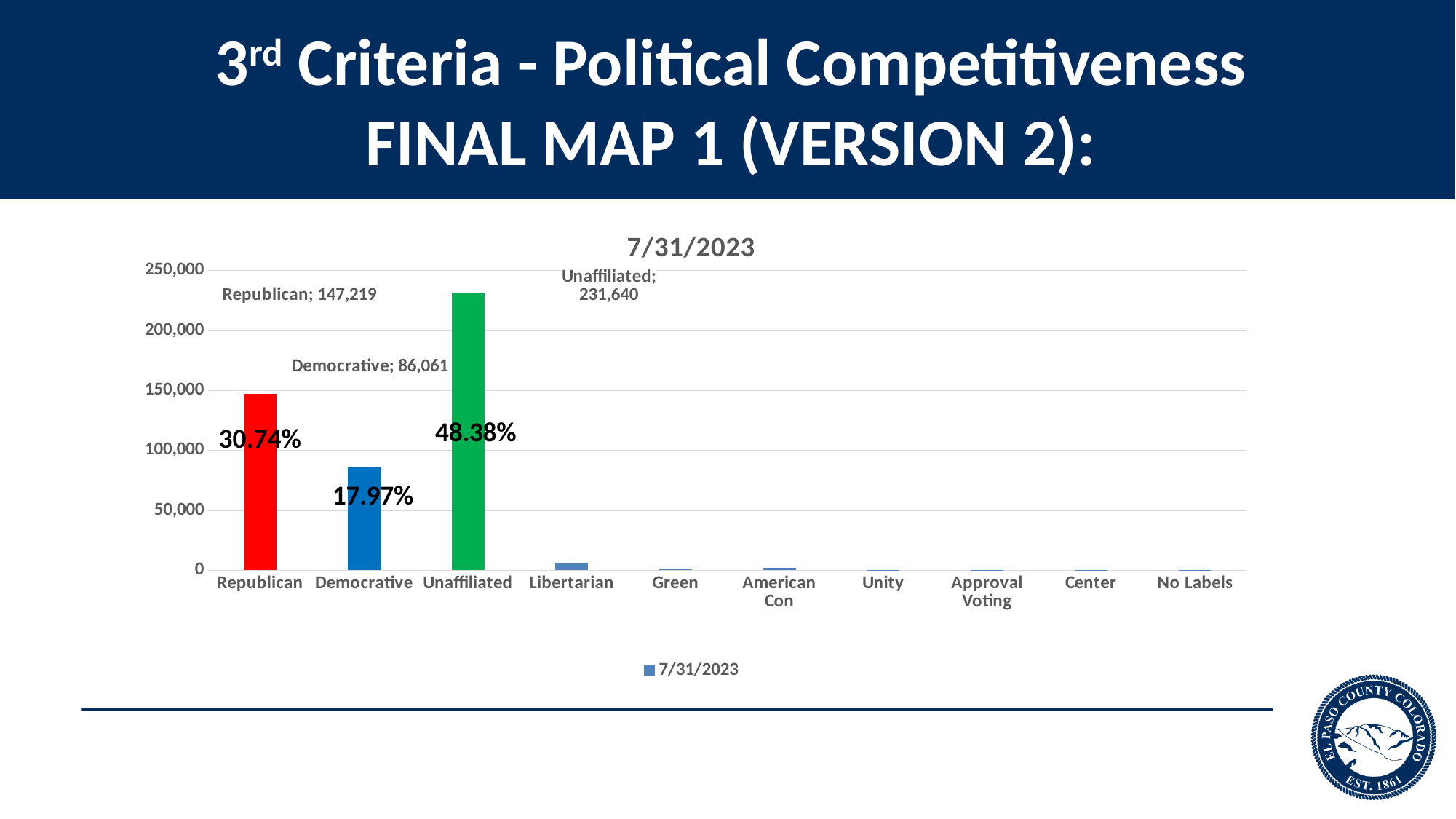
What is the value for Democrative? 86,061 How many series does the legend list? 1 What kind of chart is shown on the slide? bar chart Which is larger, the value for Republican or the value for Democrative? Republican Which category has the highest value? Unaffiliated What is the value for Unaffiliated? 231,640 What is the difference between the Unaffiliated and Republican values? 84,421 What percentage label is shown on the Unaffiliated bar? 48.38% Is the value for Libertarian greater or less than 50,000? less How many categories are shown on the x axis? 10 What is the title of the chart? 7/31/2023 What is the value for Republican? 147,219